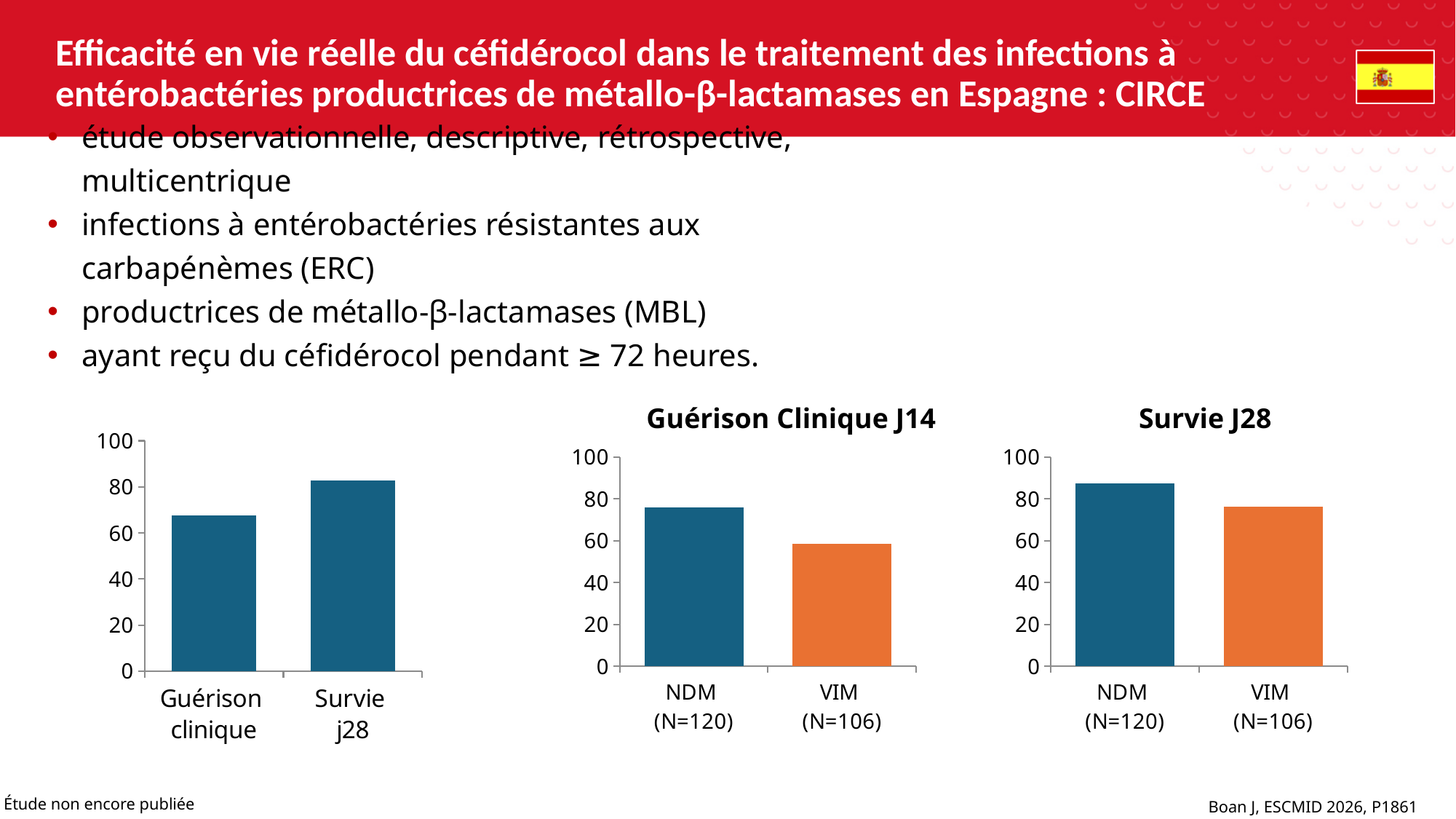
In the leftmost chart, is the value for 'Survie j28' greater or less than 80? greater In the chart titled 'Guérison Clinique J14', is the value for VIM greater or less than 80? less In the chart titled 'Survie J28', is the value for VIM greater or less than 80? less In the chart titled 'Survie J28', which category has the lower bar? VIM (N=106) How many bars are shown in the chart titled 'Survie J28'? 2 What type of chart is the leftmost chart on the slide? bar chart In the chart titled 'Guérison Clinique J14', what colour is the VIM bar? orange In the leftmost chart, which bar is taller: 'Guérison clinique' or 'Survie j28'? Survie j28 In the chart titled 'Guérison Clinique J14', which category has the higher bar? NDM (N=120)